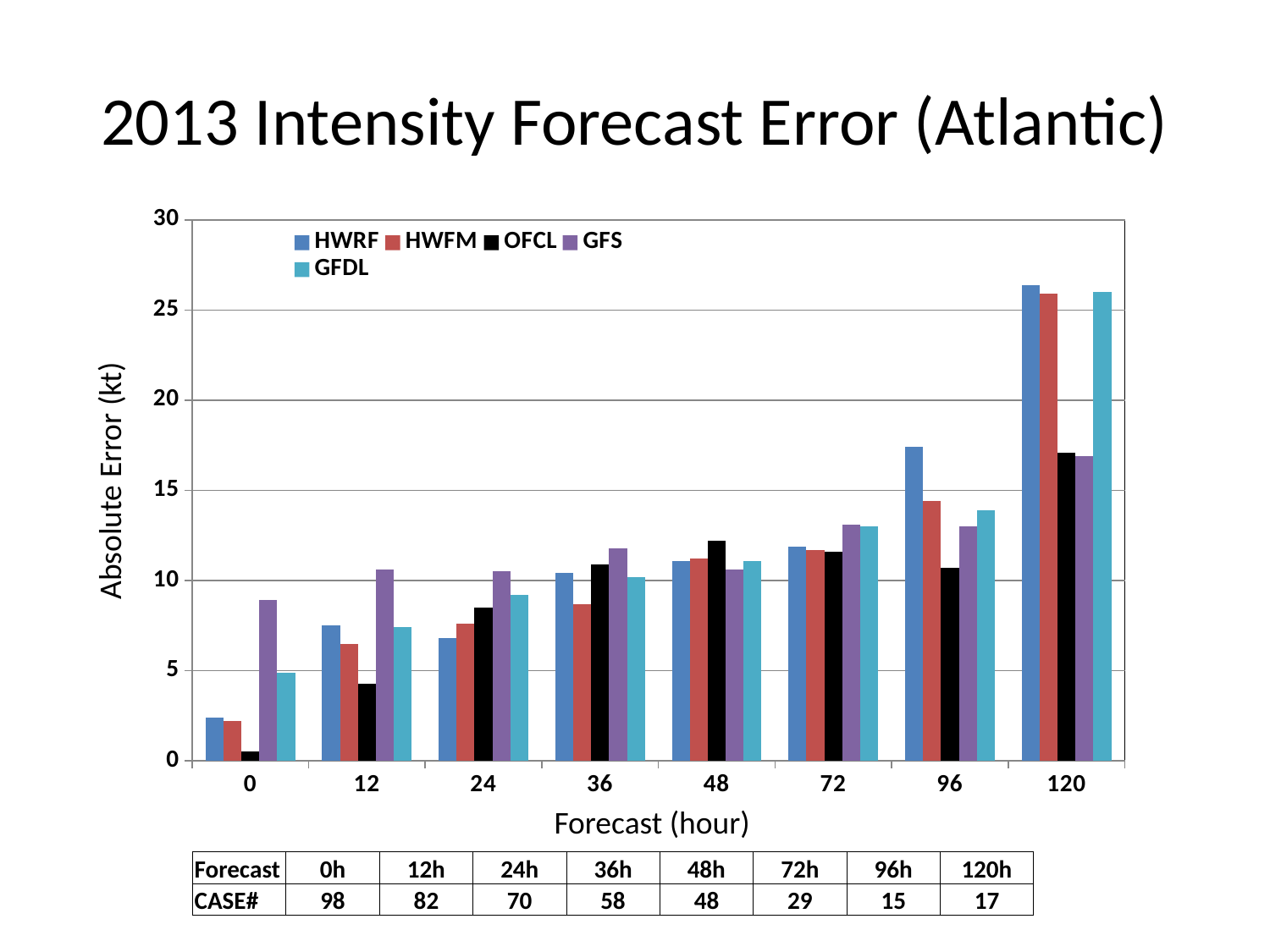
At forecast hour 96, which model has the highest absolute error? HWRF Do the HWRF values rise or fall from forecast hour 36 to forecast hour 120? rise What kind of chart is shown on the slide? bar chart How many forecast hour categories are plotted on the x axis? 8 At forecast hour 12, which is larger: the GFS error or the OFCL error? GFS Is the value for HWRF at forecast hour 120 greater or less than 25? greater What is the title of the y axis? Absolute Error (kt) At forecast hour 0, which model has the lowest absolute error? OFCL How many series does the legend list? 5 At forecast hour 0, which model has the highest absolute error? GFS Is the value for OFCL at forecast hour 96 greater or less than 15? less Is the value for GFS at forecast hour 0 greater or less than 5? greater